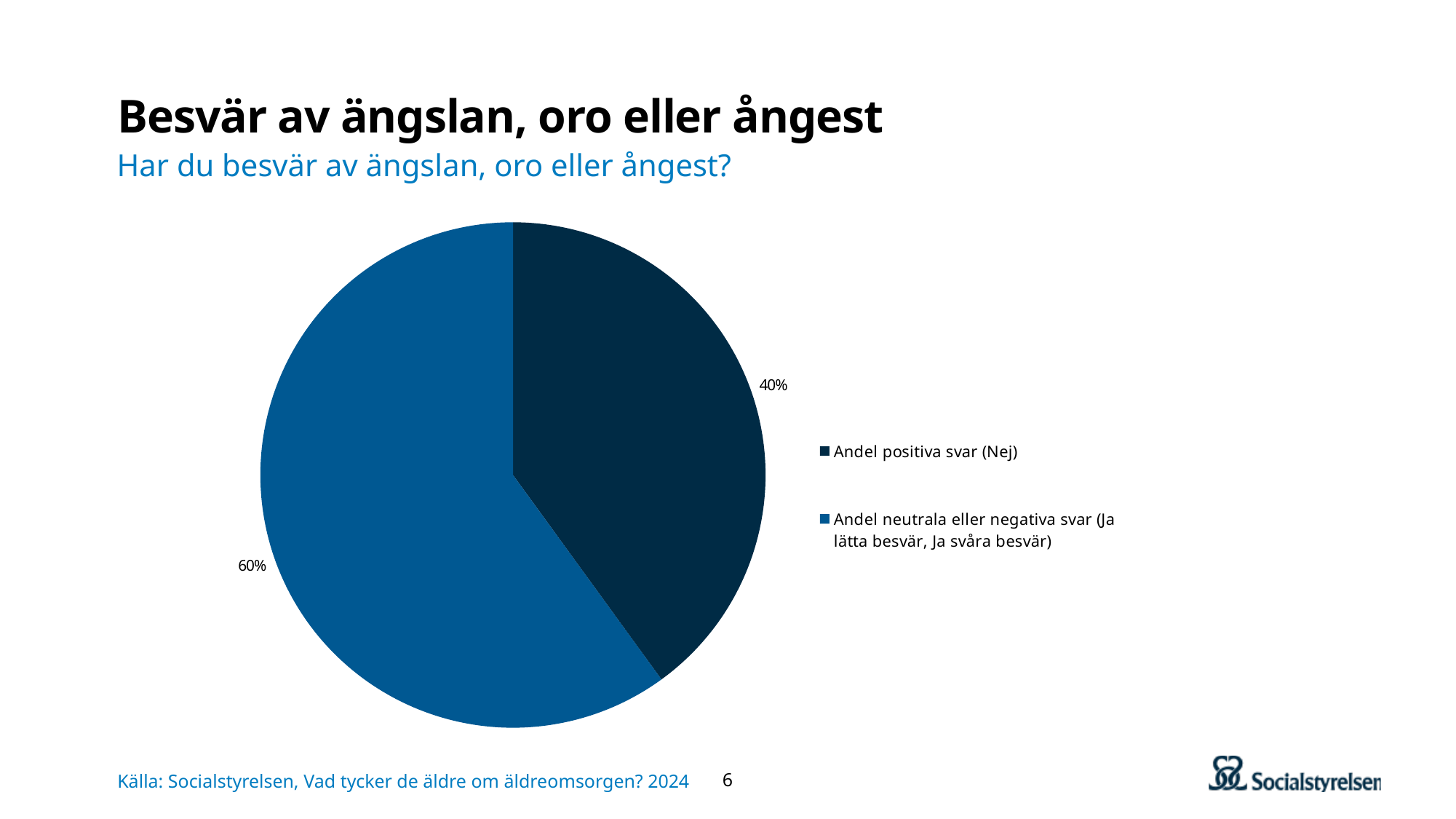
What question is shown as the subtitle above the chart? Har du besvär av ängslan, oro eller ångest? What share of the pie is labelled "Andel positiva svar (Nej)"? 40% Which slice of the pie is the largest? Andel neutrala eller negativa svar (Ja lätta besvär, Ja svåra besvär) Which slice of the pie is the smallest? Andel positiva svar (Nej) Is the share for "Andel positiva svar (Nej)" greater or less than 50%? less Which is larger: the share for "Andel positiva svar (Nej)" or the share for "Andel neutrala eller negativa svar"? Andel neutrala eller negativa svar How many slices does the pie chart have? 2 What is the difference in percentage points between the two slices of the pie? 20 percentage points How many entries does the legend list? 2 What share of the pie is labelled "Andel neutrala eller negativa svar (Ja lätta besvär, Ja svåra besvär)"? 60% What is the source cited at the bottom of the slide? Socialstyrelsen, Vad tycker de äldre om äldreomsorgen? 2024 What kind of chart is shown on the slide? pie chart